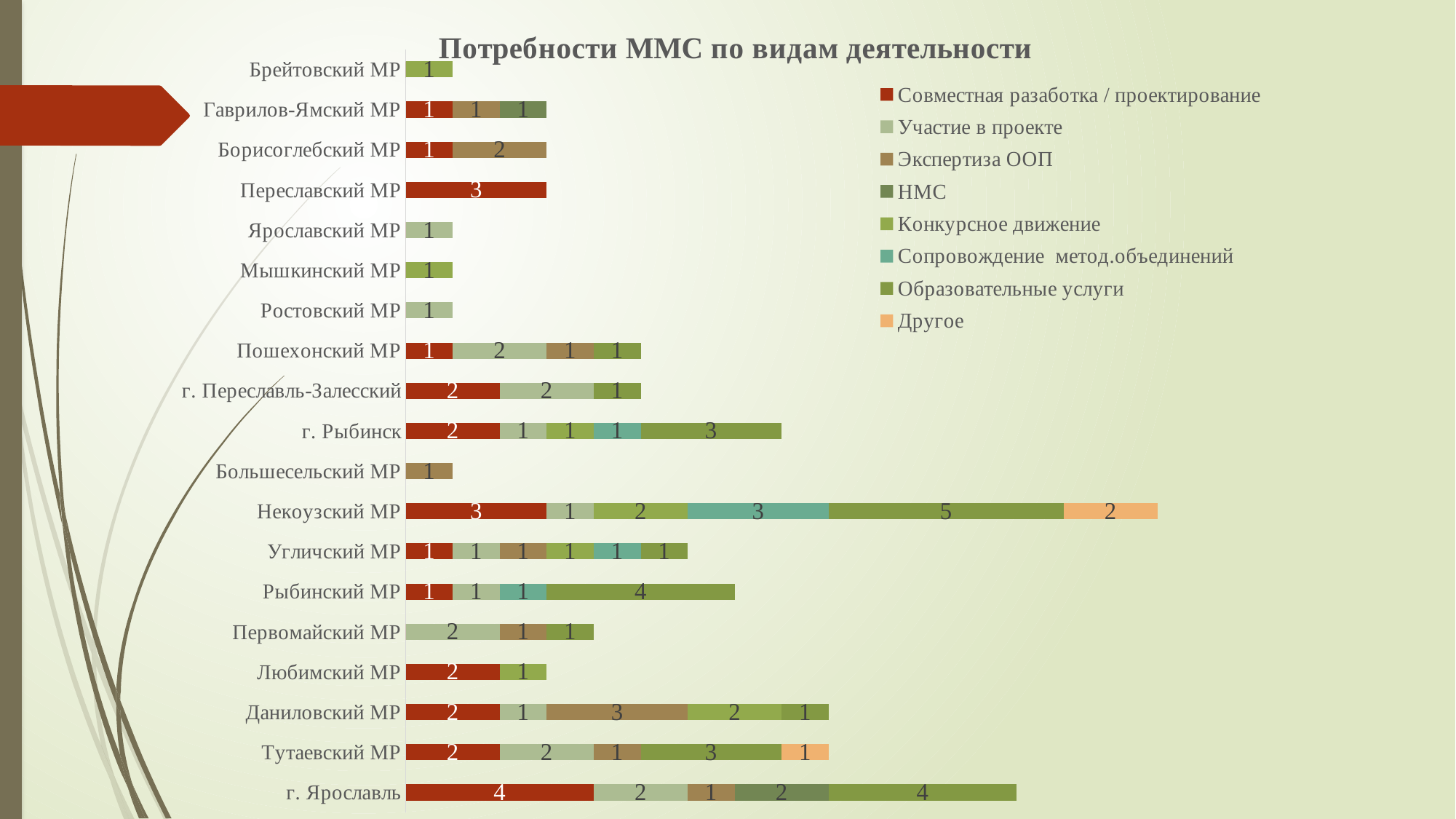
What is the value of 'Совместная разработка / проектирование' for г. Ярославль? 4 What type of chart is shown on the slide? Stacked horizontal bar chart What is the total of the stacked bar for Некоузский МР? 16 What is the total of the stacked bar for г. Рыбинск? 8 How many categories (districts/cities) are shown on the vertical axis? 19 How many series does the legend list? 8 What is the difference between the 'Образовательные услуги' values for Некоузский МР and Рыбинский МР? 1 What is the title of the chart? Потребности ММС по видам деятельности Which is larger: the 'Совместная разработка / проектирование' value for Переславский МР or for Любимский МР? Переславский МР Which category has the longest total stacked bar? Некоузский МР What is the value of 'Экспертиза ООП' for Даниловский МР? 3 What is the value of 'Образовательные услуги' for Некоузский МР? 5